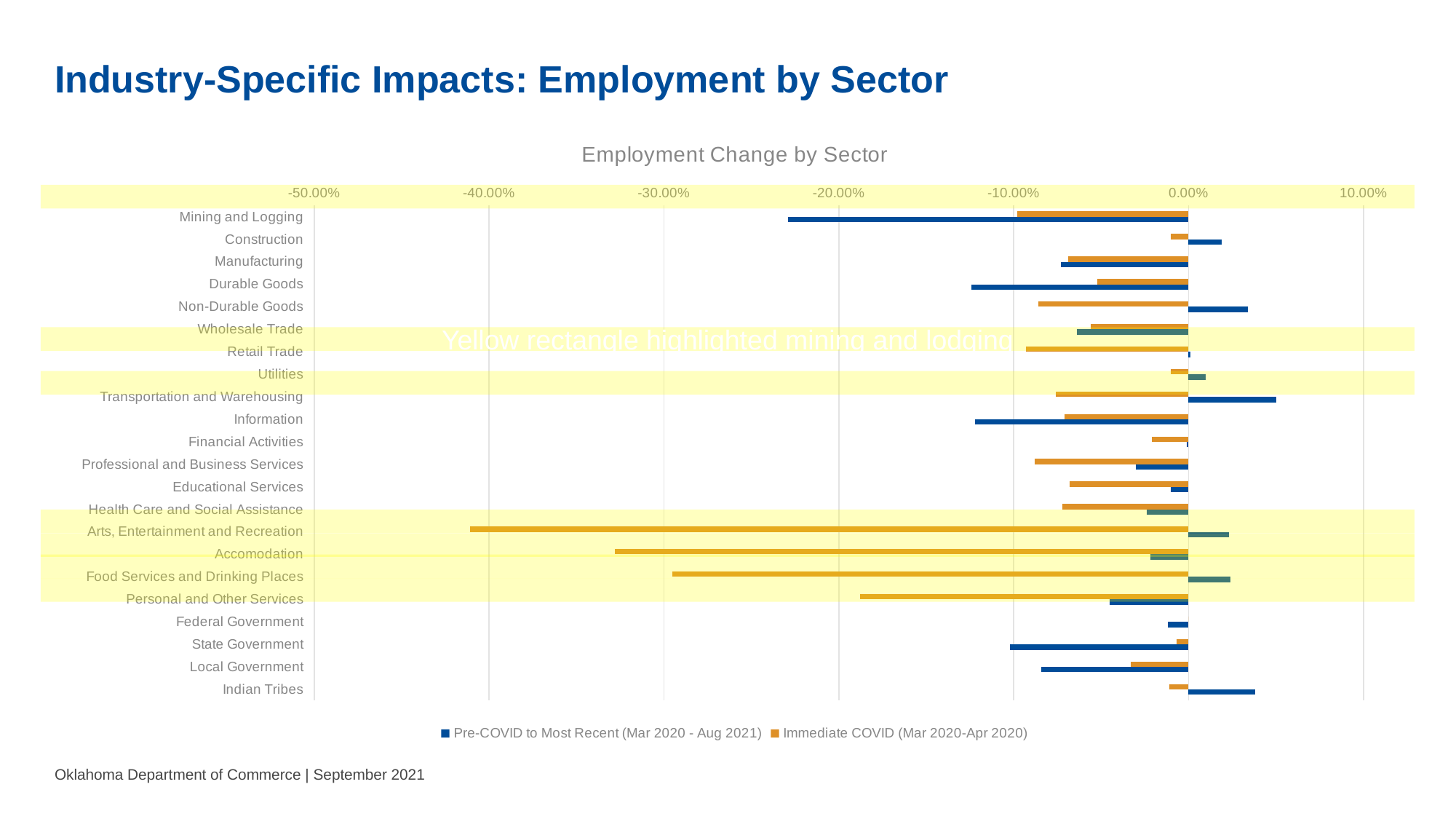
Is the Immediate COVID value for Personal and Other Services greater or less than -10.00%? less What is the title of the chart? Employment Change by Sector How many sectors are plotted on the chart? 22 What kind of chart is shown on the slide? Bar chart Which series is shown in orange? Immediate COVID (Mar 2020-Apr 2020) Is the Pre-COVID to Most Recent value for Mining and Logging greater or less than -20.00%? less Which sector has the lowest value for the Immediate COVID (Mar 2020-Apr 2020) series? Arts, Entertainment and Recreation Is the Immediate COVID value for Accomodation greater or less than -30.00%? less For Mining and Logging, which series shows the larger decline: Pre-COVID to Most Recent or Immediate COVID? Pre-COVID to Most Recent Which sector has the highest value for the Pre-COVID to Most Recent (Mar 2020 - Aug 2021) series? Transportation and Warehousing How many series does the legend list? 2 Which sector has the lowest value for the Pre-COVID to Most Recent (Mar 2020 - Aug 2021) series? Mining and Logging